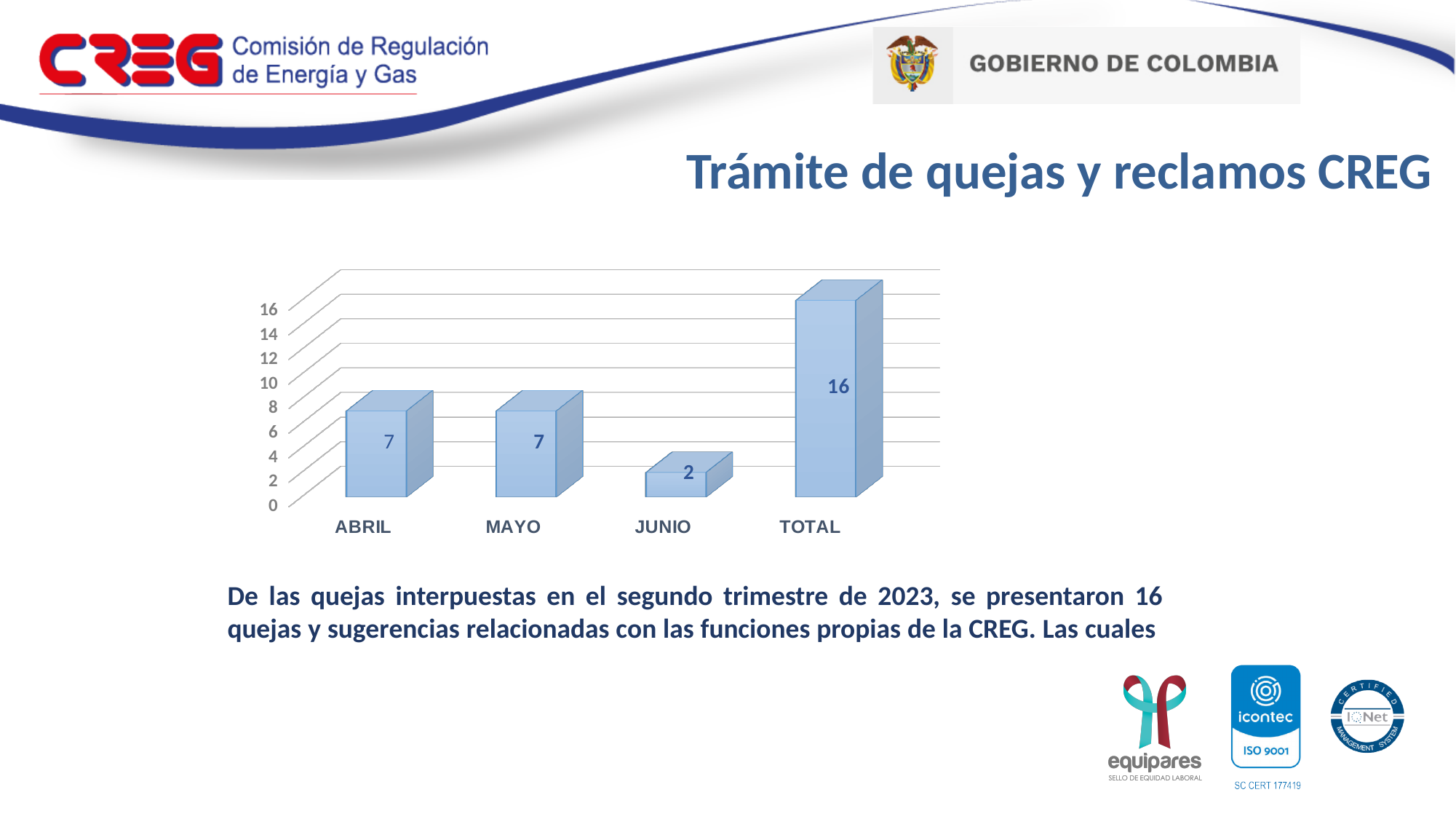
What is the value for ABRIL? 7 How many categories are shown on the x axis? 4 What is the difference between the values for MAYO and JUNIO? 5 What is the value for JUNIO? 2 Which category has the lowest value? JUNIO What is the value for MAYO? 7 What is the highest tick value shown on the vertical axis? 16 Is the value for TOTAL greater or less than 10? greater Which is larger, the value for ABRIL or the value for JUNIO? ABRIL What is the value for TOTAL? 16 What kind of chart is shown on the slide? bar chart Which category has the highest value? TOTAL